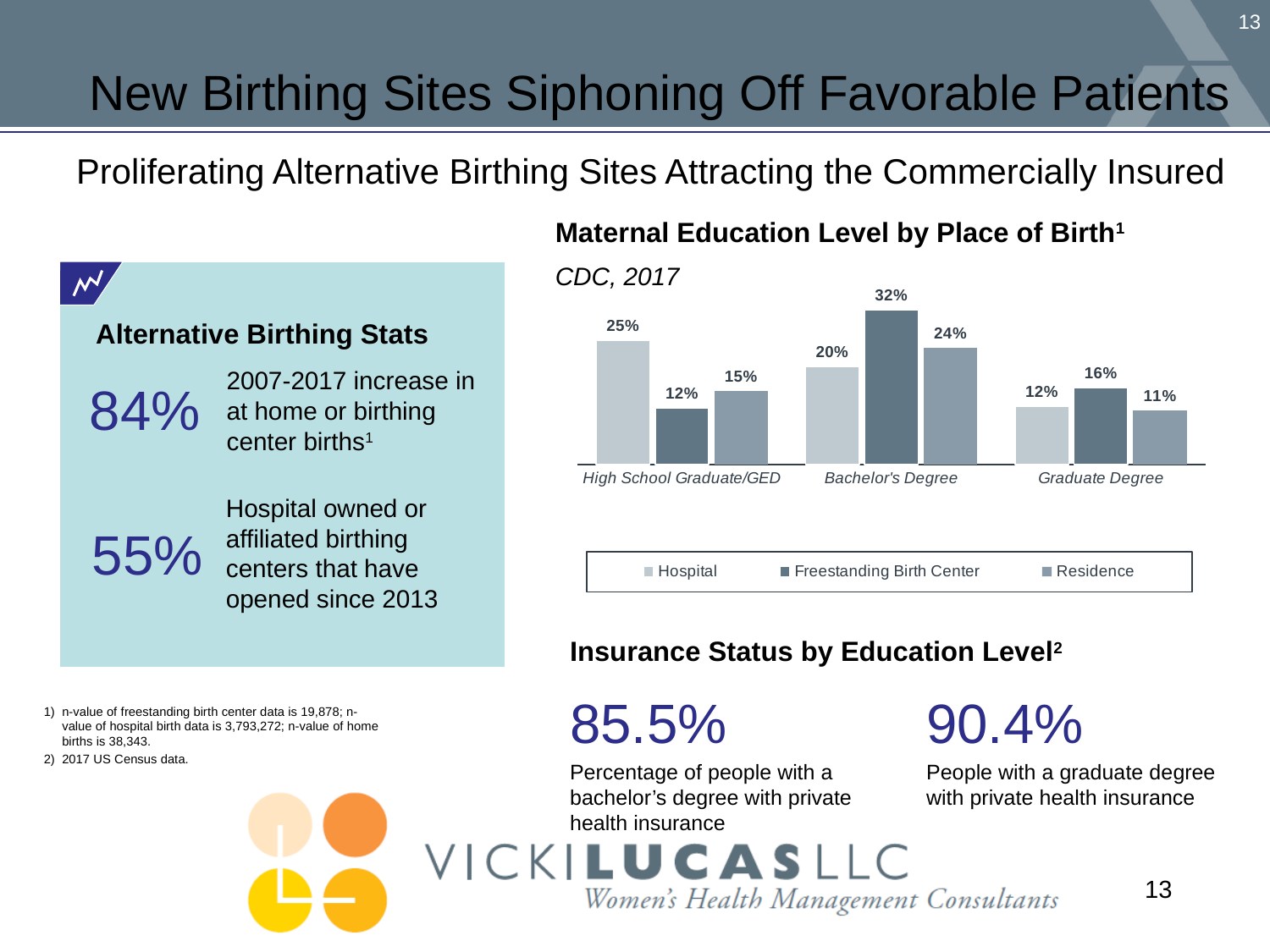
What is the difference between the Freestanding Birth Center and Hospital values for Bachelor's Degree? 12% How many series does the legend list? 3 Which education level has the highest Freestanding Birth Center value? Bachelor's Degree What is the Freestanding Birth Center value for Bachelor's Degree? 32% Which education level has the lowest Hospital value? Graduate Degree What is the Residence value for Graduate Degree? 11% How many education level categories are shown on the x axis? 3 For High School Graduate/GED, which is larger: the Hospital value or the Residence value? Hospital What is the Residence value for Bachelor's Degree? 24% What is the Hospital value for High School Graduate/GED? 25% What is the title of the chart? Maternal Education Level by Place of Birth What kind of chart is shown? Bar chart